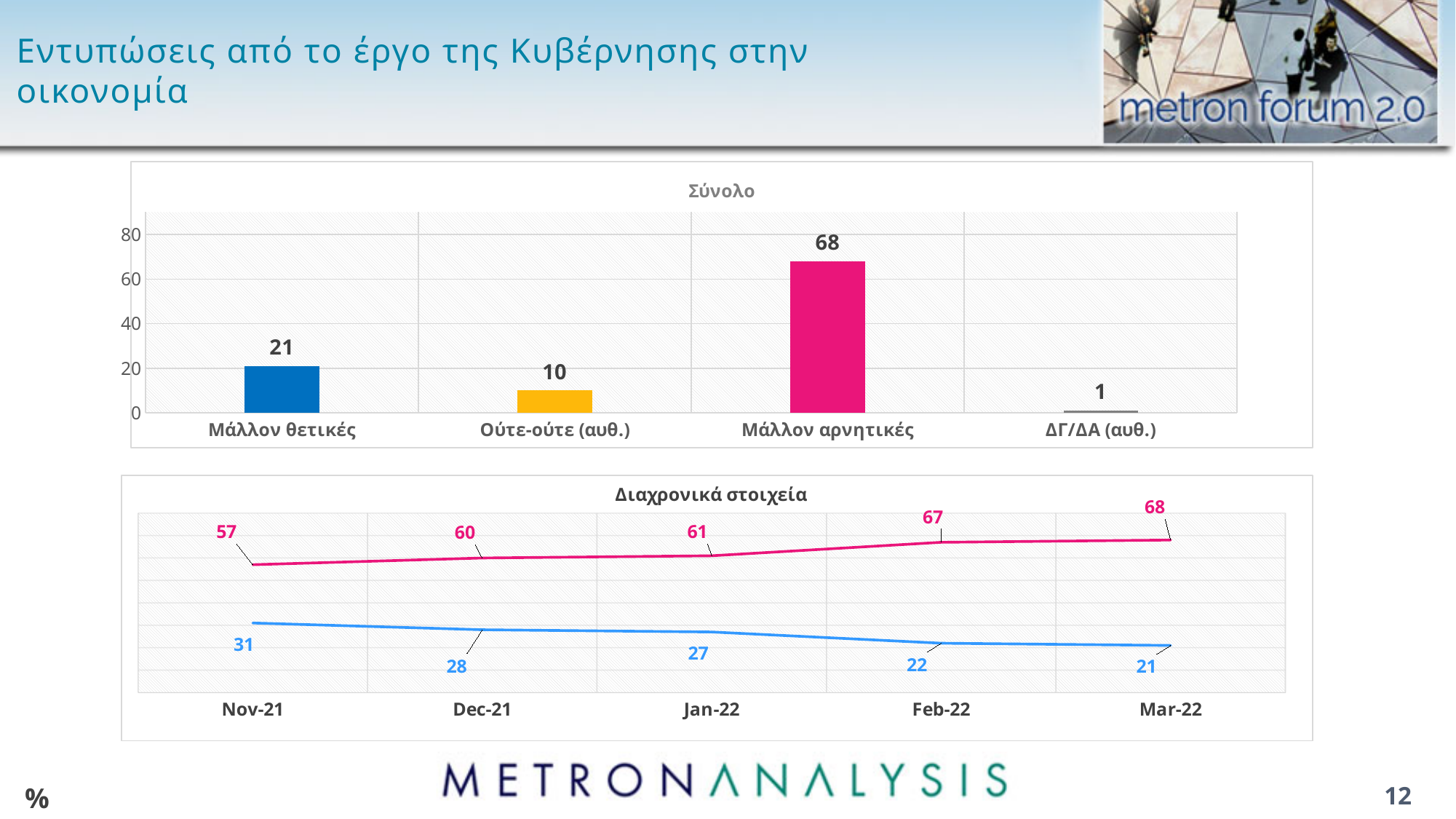
In the 'Σύνολο' chart, what is the value for 'Μάλλον αρνητικές'? 68 In the 'Σύνολο' chart, which category has the highest value? Μάλλον αρνητικές In the 'Διαχρονικά στοιχεία' chart, what is the value of the blue line at Dec-21? 28 In the 'Διαχρονικά στοιχεία' chart, does the blue line rise or fall from Nov-21 to Mar-22? Fall In the 'Σύνολο' chart, what is the difference between 'Μάλλον αρνητικές' and 'Μάλλον θετικές'? 47 In the 'Σύνολο' chart, which category has the lowest value? ΔΓ/ΔΑ (αυθ.) What kind of chart is the 'Σύνολο' chart? Bar chart In the 'Σύνολο' chart, what is the value for 'Ούτε-ούτε (αυθ.)'? 10 In the 'Διαχρονικά στοιχεία' chart, how many time points are shown on the x axis? 5 In the 'Σύνολο' chart, how many categories are shown? 4 In the 'Διαχρονικά στοιχεία' chart, what is the value of the pink line at Feb-22? 67 In the 'Διαχρονικά στοιχεία' chart, what is the difference between the pink and blue lines at Nov-21? 26